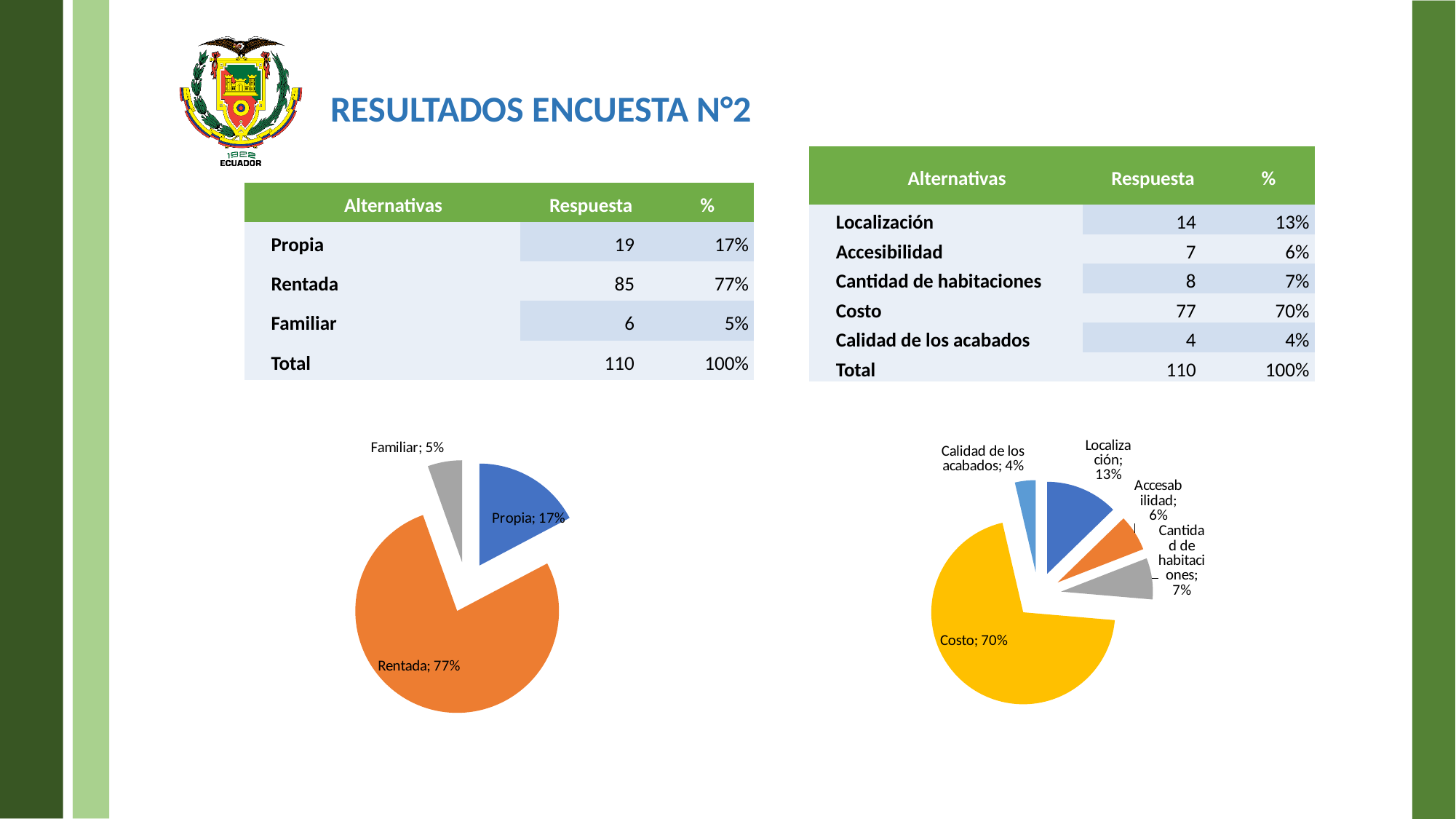
In the right pie chart, how many slices are there? 5 What kind of chart is the chart on the right side of the slide? Pie chart In the left pie chart, what share does Rentada have? 77% In the left pie chart, which category has the largest slice? Rentada In the left pie chart, how many slices are there? 3 In the right pie chart, which category has the smallest slice? Calidad de los acabados In the right pie chart, what share does Costo have? 70% In the left pie chart, which category has the smallest slice? Familiar In the left pie chart, what is the difference in percentage points between Rentada and Propia? 60 In the right pie chart, which is larger, Accesibilidad or Cantidad de habitaciones? Cantidad de habitaciones In the left pie chart, what share does Propia have? 17% In the right pie chart, what share does Localización have? 13%